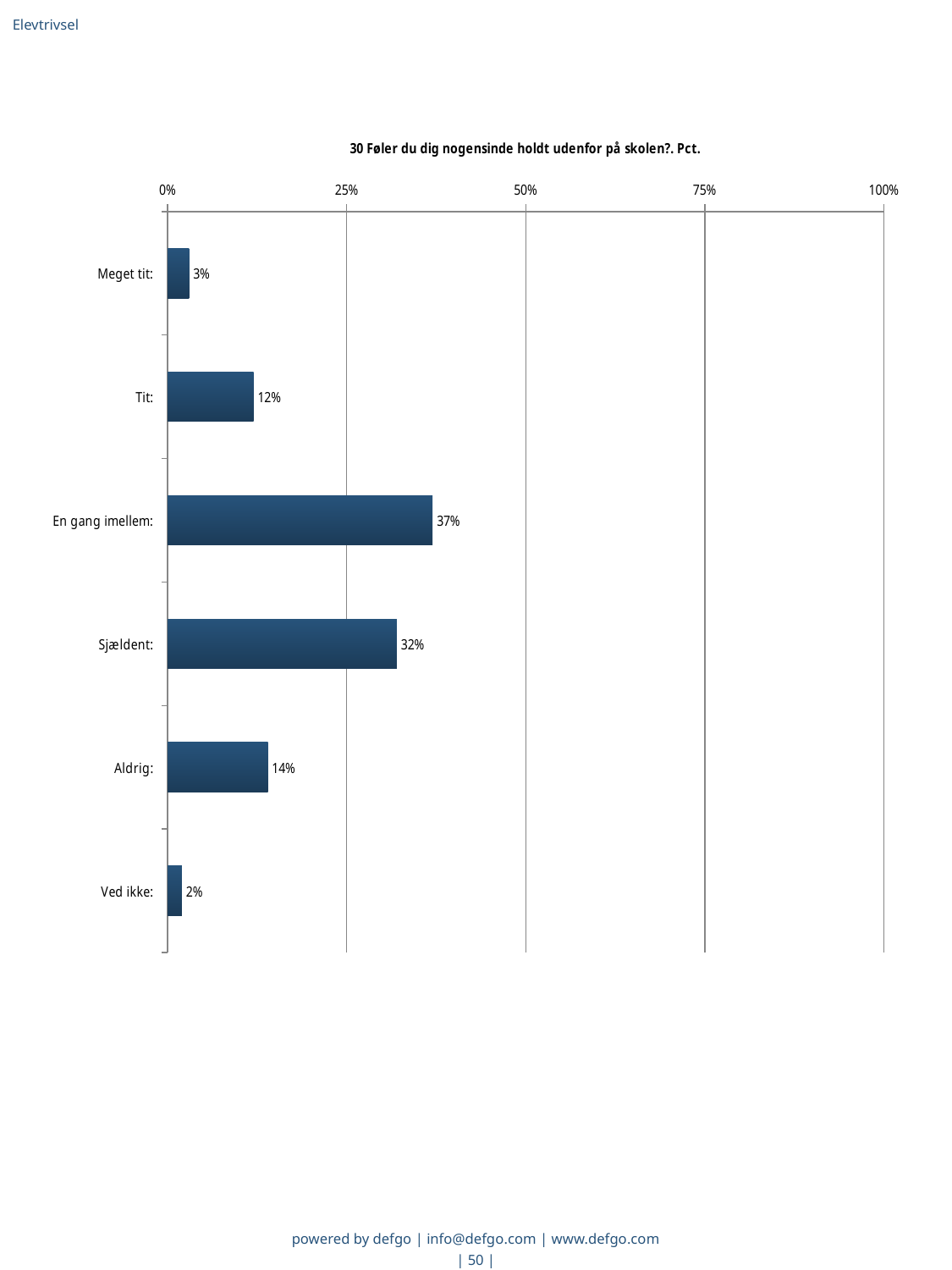
What is the title of the chart? 30 Føler du dig nogensinde holdt udenfor på skolen?. Pct. How many categories are shown in the chart? 6 Is the value for "Sjældent:" greater or less than 25%? greater What is the value for "Meget tit:"? 3% What is the difference between the values for "En gang imellem:" and "Sjældent:"? 5% What kind of chart is shown on the slide? bar chart Which category has the highest value? En gang imellem: What is the value for "Sjældent:"? 32% What is the value for "En gang imellem:"? 37% What is the value for "Aldrig:"? 14% Which is larger, the value for "Tit:" or the value for "Aldrig:"? Aldrig: Which category has the lowest value? Ved ikke: